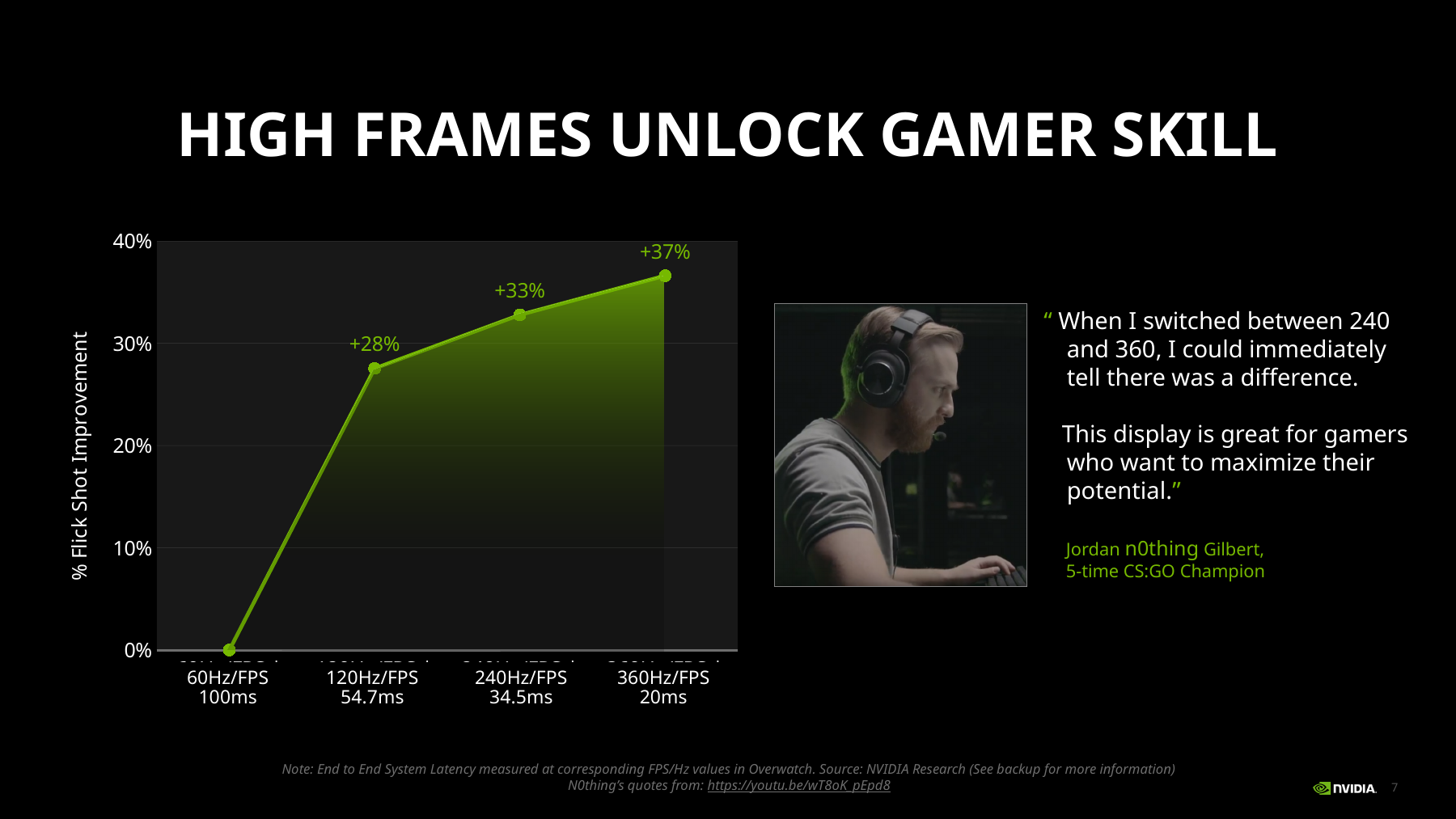
What is the % Flick Shot Improvement shown for 120Hz/FPS (54.7ms)? +28% Which has a larger % Flick Shot Improvement, 240Hz/FPS or 120Hz/FPS? 240Hz/FPS What kind of chart is used to show % Flick Shot Improvement? Line chart What is the label on the vertical axis of the chart? % Flick Shot Improvement How many refresh rate/FPS settings are plotted on the chart? 4 What is the % Flick Shot Improvement shown for 240Hz/FPS (34.5ms)? +33% Which refresh rate/FPS setting has the lowest % Flick Shot Improvement? 60Hz/FPS What is the difference in % Flick Shot Improvement between 360Hz/FPS and 120Hz/FPS? 9% What is the % Flick Shot Improvement for 60Hz/FPS (100ms)? 0% Does the % Flick Shot Improvement rise or fall as the refresh rate increases from 60Hz to 360Hz? Rise Which refresh rate/FPS setting has the highest % Flick Shot Improvement? 360Hz/FPS What is the % Flick Shot Improvement shown for 360Hz/FPS (20ms)? +37%